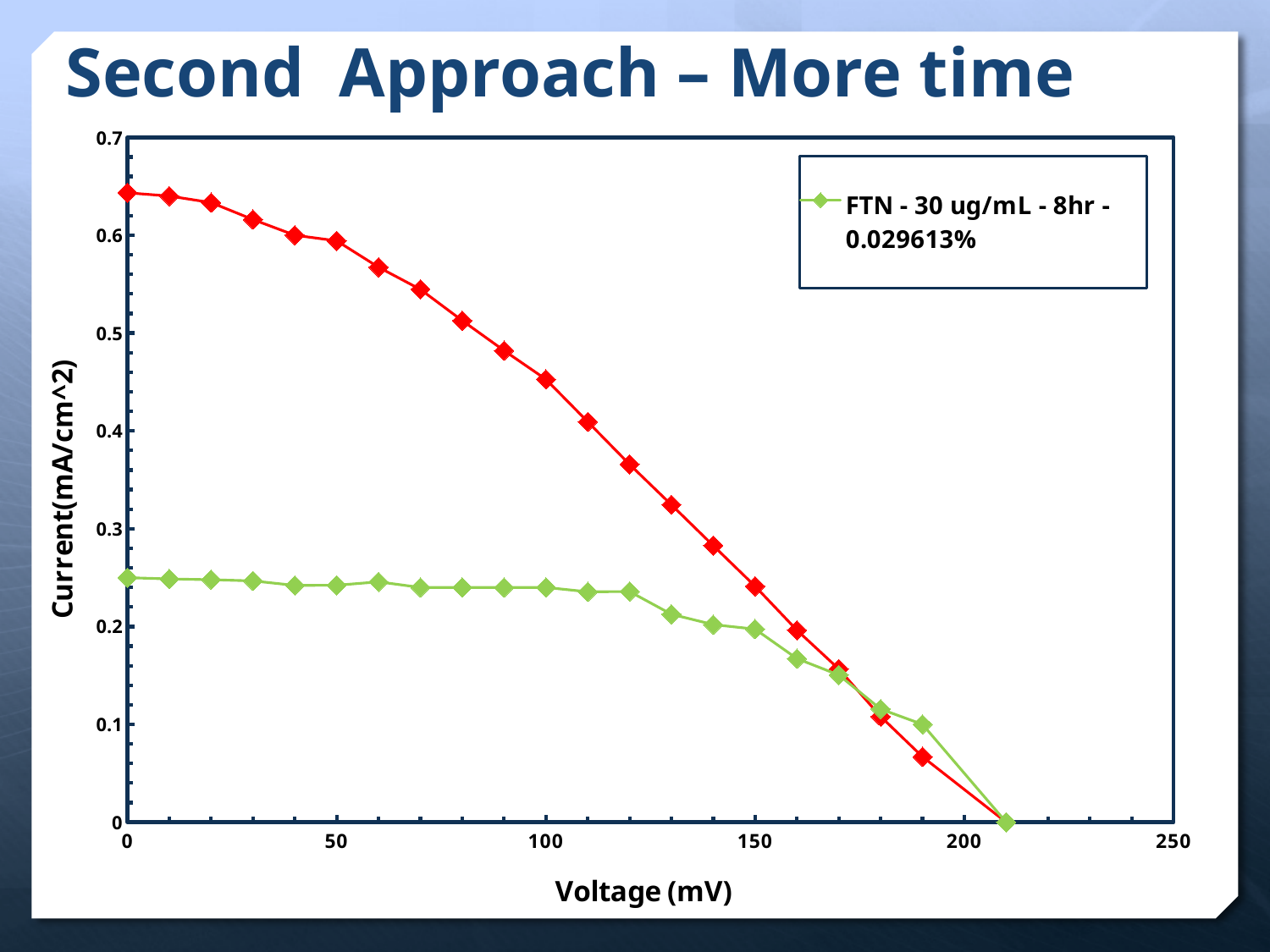
Is the value of the red series at 60 mV greater or less than 0.6? less At 0 mV, which series has the higher current, the red series or the green series? the red series Is the value of the red series at 0 mV greater or less than 0.6? greater What kind of chart is shown on the slide? line chart Is the value of the green series at 0 mV greater or less than 0.3? less What is the title of the x axis? Voltage (mV) How many series does the legend list? 1 Does the current of the red series rise or fall as voltage increases? fall What is the legend entry for the green series? FTN - 30 ug/mL - 8hr - 0.029613%